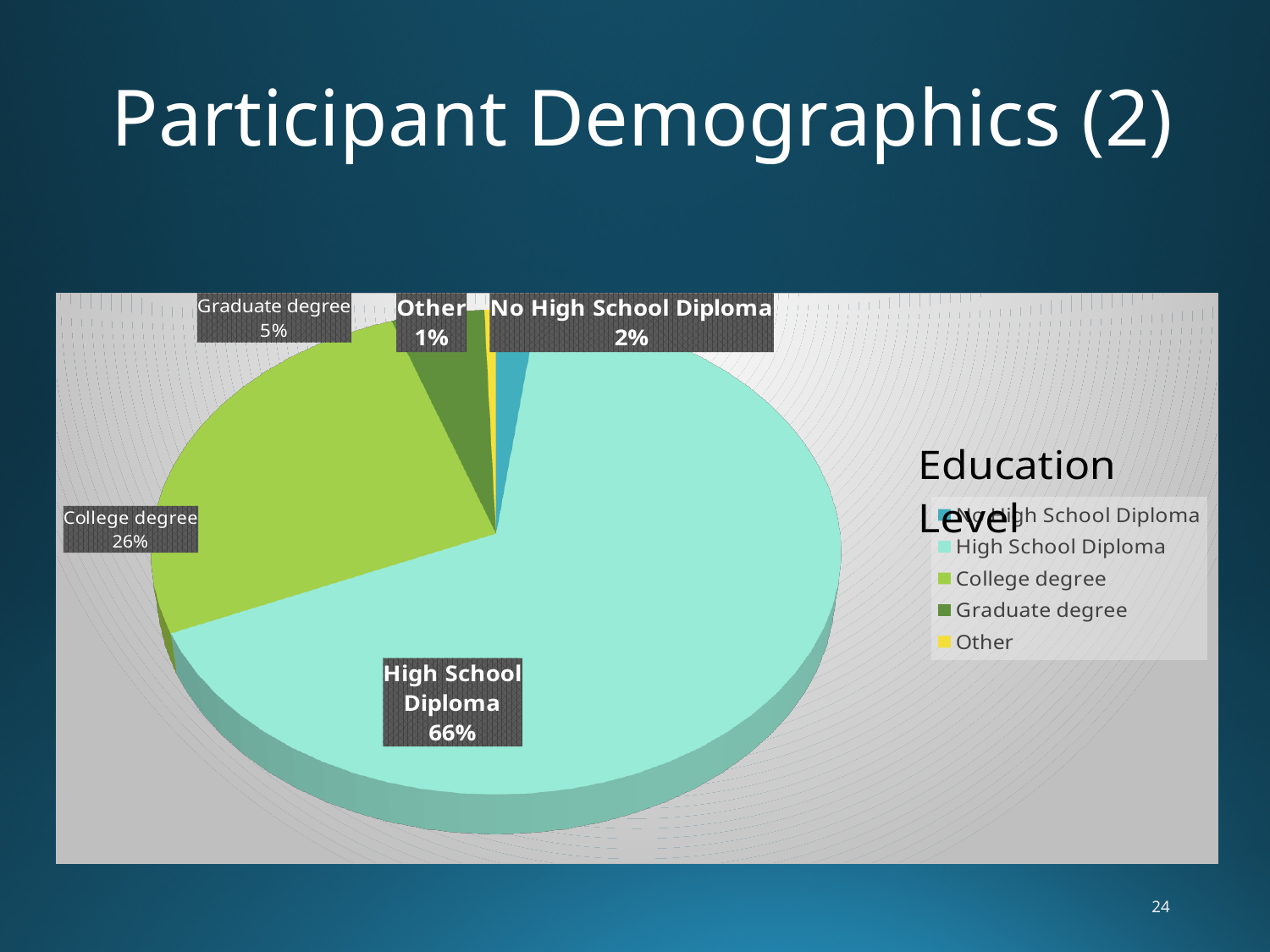
Which education level has the smallest share of participants? Other What percentage of participants have a Graduate degree? 5% What is the title of the chart's legend? Education Level What is the difference in percentage points between High School Diploma and College degree? 40 What percentage of participants have a College degree? 26% What percentage of participants have No High School Diploma? 2% How many education level categories are shown in the pie chart? 5 What type of chart is shown on the slide? Pie chart Which education level has the largest share of participants? High School Diploma Which is larger, the share for Graduate degree or the share for No High School Diploma? Graduate degree What percentage of participants have a High School Diploma? 66% What percentage of participants fall under Other? 1%